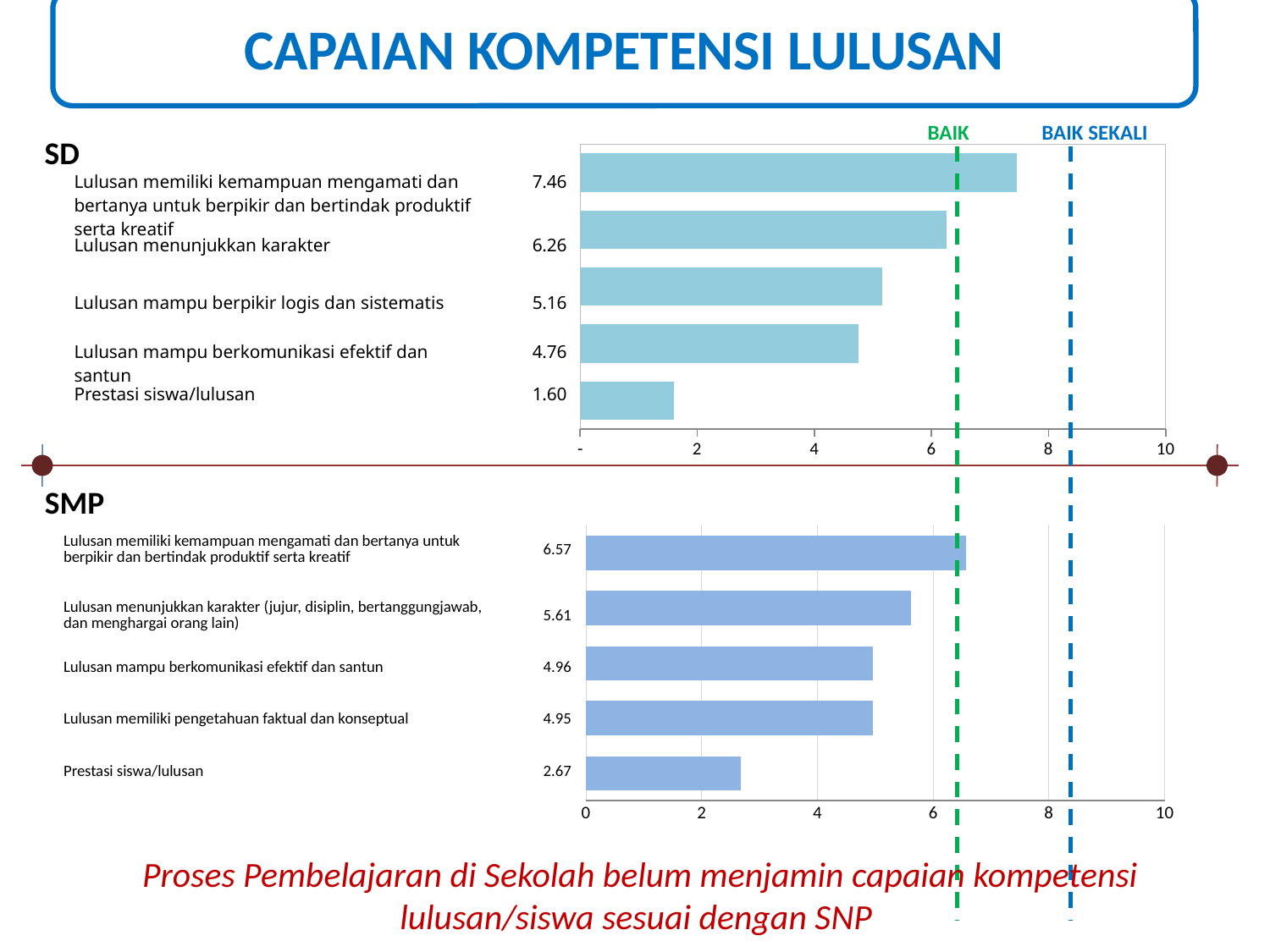
In the SMP chart, what is the value for Prestasi siswa/lulusan? 2.67 In the SD chart, what is the difference between the values for Lulusan menunjukkan karakter and Lulusan mampu berkomunikasi efektif dan santun? 1.50 How many categories are shown in the SMP chart? 5 What are the labels of the two dashed vertical reference lines shown on the slide? BAIK and BAIK SEKALI Which is larger: the value for Prestasi siswa/lulusan in the SD chart or in the SMP chart? SMP In the SMP chart, which category has the lowest value? Prestasi siswa/lulusan What kind of chart is the SD chart? Bar chart In the SD chart, what is the value for Prestasi siswa/lulusan? 1.60 In the SD chart, what is the value for Lulusan mampu berpikir logis dan sistematis? 5.16 In the SD chart, which category has the highest value? Lulusan memiliki kemampuan mengamati dan bertanya untuk berpikir dan bertindak produktif serta kreatif In the SMP chart, what is the value for Lulusan menunjukkan karakter (jujur, disiplin, bertanggungjawab, dan menghargai orang lain)? 5.61 In the SMP chart, what is the difference between the values for Lulusan memiliki kemampuan mengamati dan bertanya untuk berpikir dan bertindak produktif serta kreatif and Prestasi siswa/lulusan? 3.90